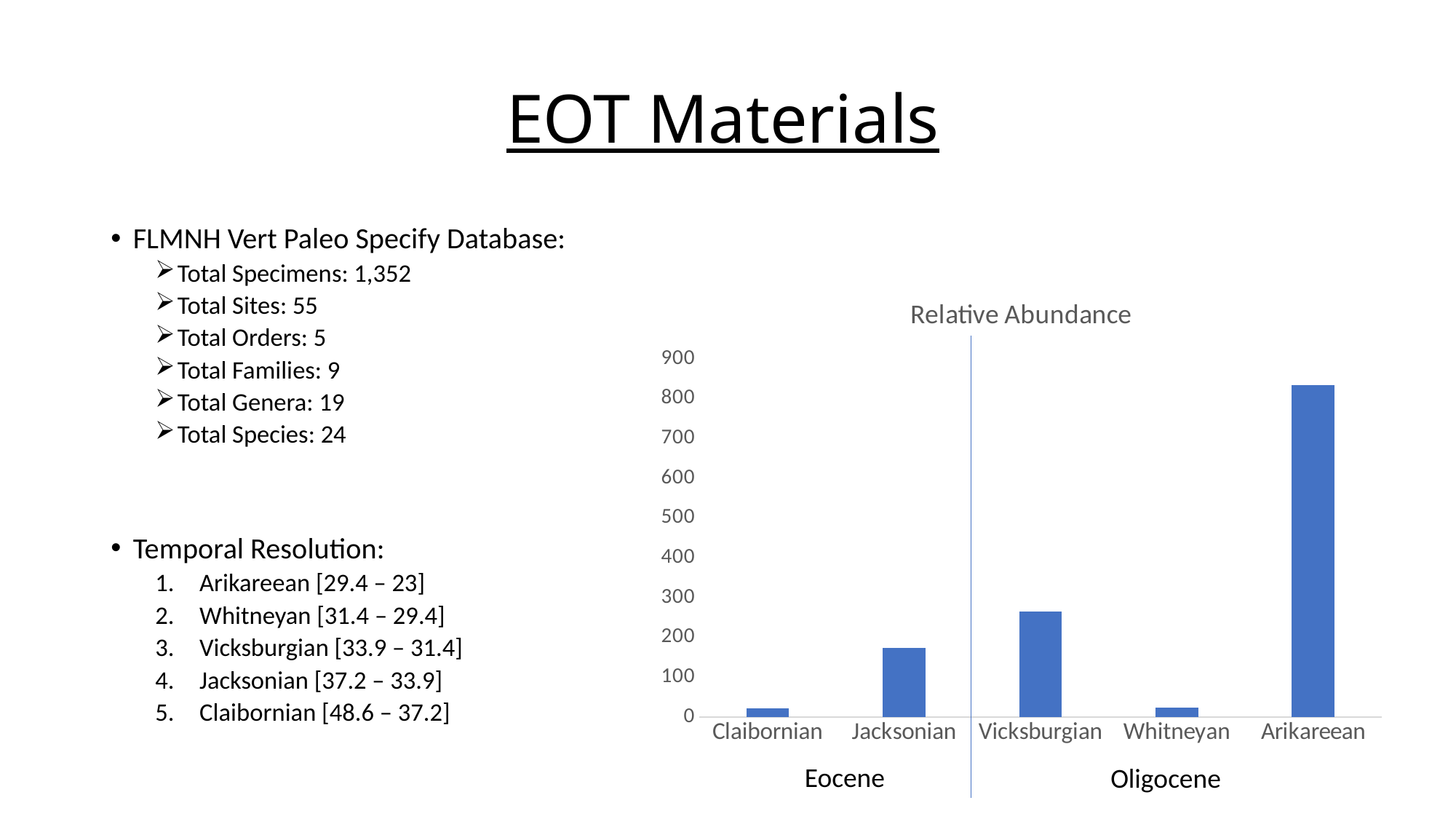
Is the value for Whitneyan greater or less than 100? less Is the value for Claibornian greater or less than 100? less Is the value for Arikareean greater or less than 800? greater What is the title of the chart? Relative Abundance Which two epoch labels appear below the x axis of the chart? Eocene and Oligocene What kind of chart is shown on the slide? bar chart Which category has the highest value in the chart? Arikareean Which has a larger value, Vicksburgian or Jacksonian? Vicksburgian Which has a larger value, Arikareean or Vicksburgian? Arikareean How many categories are plotted on the x axis of the chart? 5